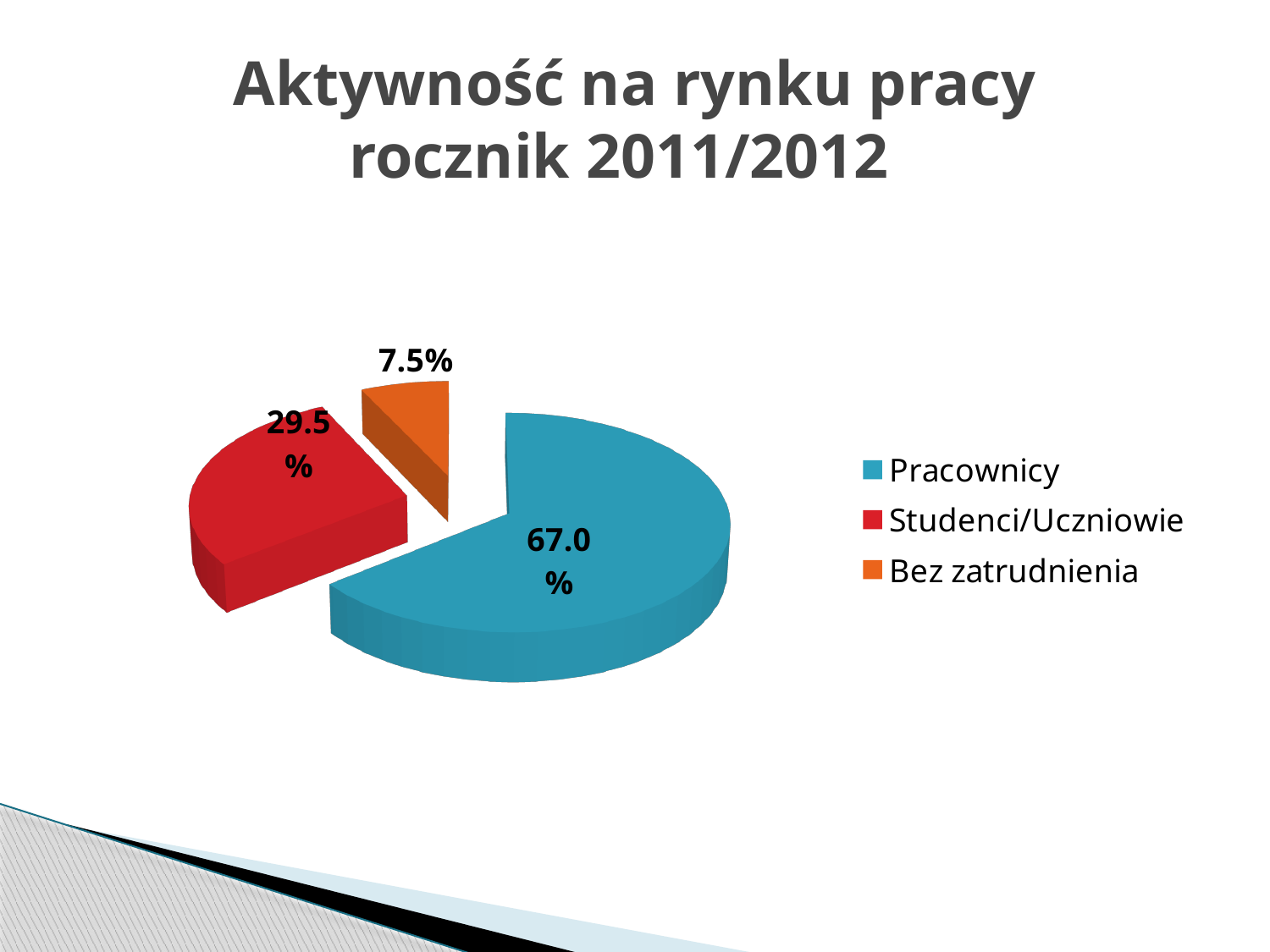
What percentage of the pie is labelled Pracownicy? 67.0% Which category has the smallest share of the pie? Bez zatrudnienia Which is larger, the share for Studenci/Uczniowie or the share for Bez zatrudnienia? Studenci/Uczniowie How many slices does the pie chart have? 3 What is the difference in percentage points between Studenci/Uczniowie and Bez zatrudnienia? 22.0 What is the difference in percentage points between Pracownicy and Studenci/Uczniowie? 37.5 Which category has the largest share of the pie? Pracownicy What kind of chart is shown on the slide? Pie chart Which colour represents Bez zatrudnienia in the legend? Orange What percentage of the pie is labelled Studenci/Uczniowie? 29.5% What percentage of the pie is labelled Bez zatrudnienia? 7.5% What is the title of the slide containing the chart? Aktywność na rynku pracy rocznik 2011/2012